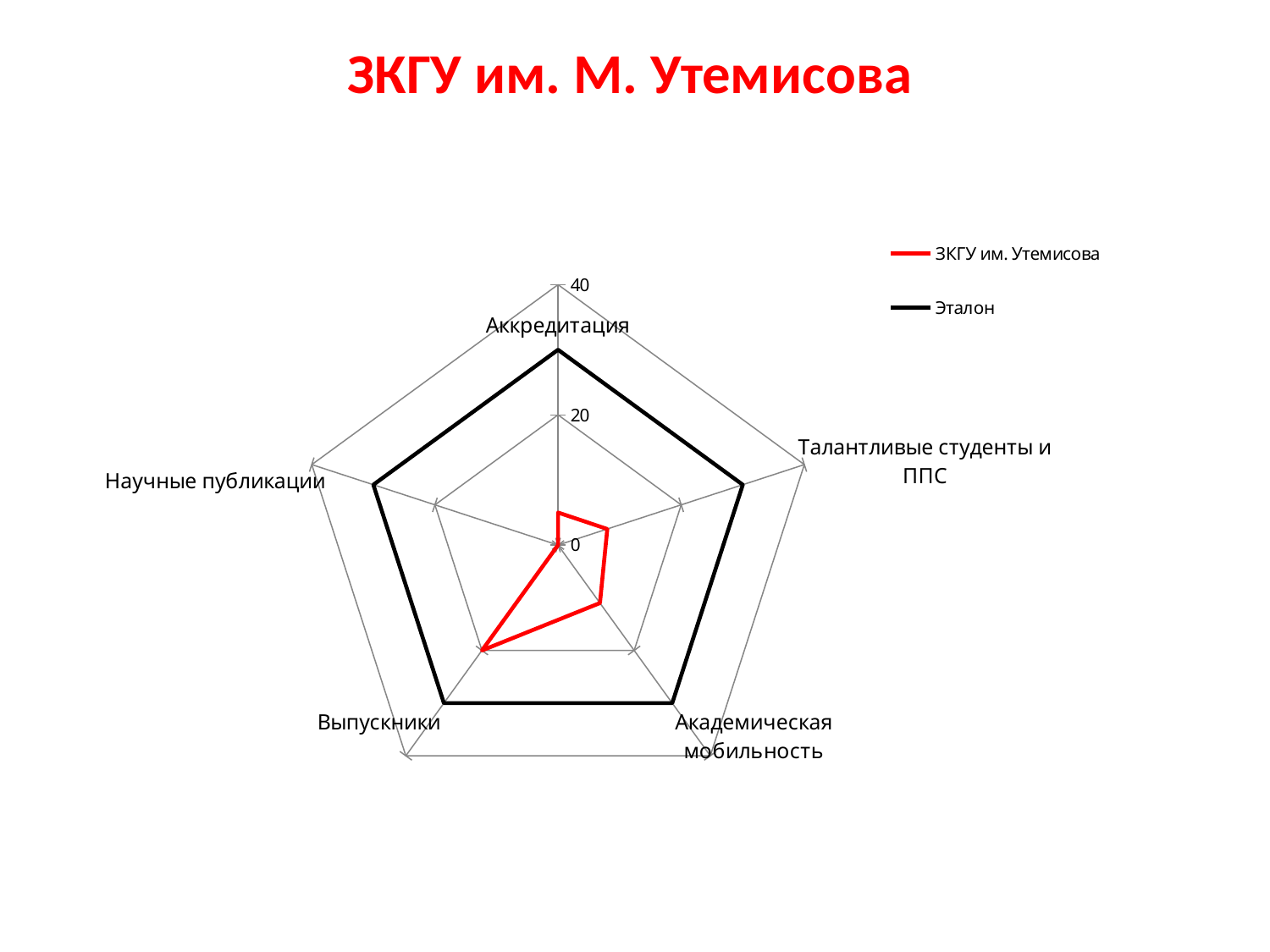
How many series does the legend list? 2 Is the Эталон value for Аккредитация greater or less than 20? greater Is the ЗКГУ им. Утемисова value for Аккредитация greater or less than 20? less For Талантливые студенты и ППС, which series has the larger value, ЗКГУ им. Утемисова or Эталон? Эталон Is the ЗКГУ им. Утемисова value for Академическая мобильность greater or less than 20? less What kind of chart is shown on the slide? Radar chart How many categories (axes) does the radar chart have? 5 Which series is drawn in red in the chart? ЗКГУ им. Утемисова For the ЗКГУ им. Утемисова series, which category has the highest value? Выпускники For the ЗКГУ им. Утемисова series, which category has the lowest value? Научные публикации What is the title of the slide? ЗКГУ им. М. Утемисова